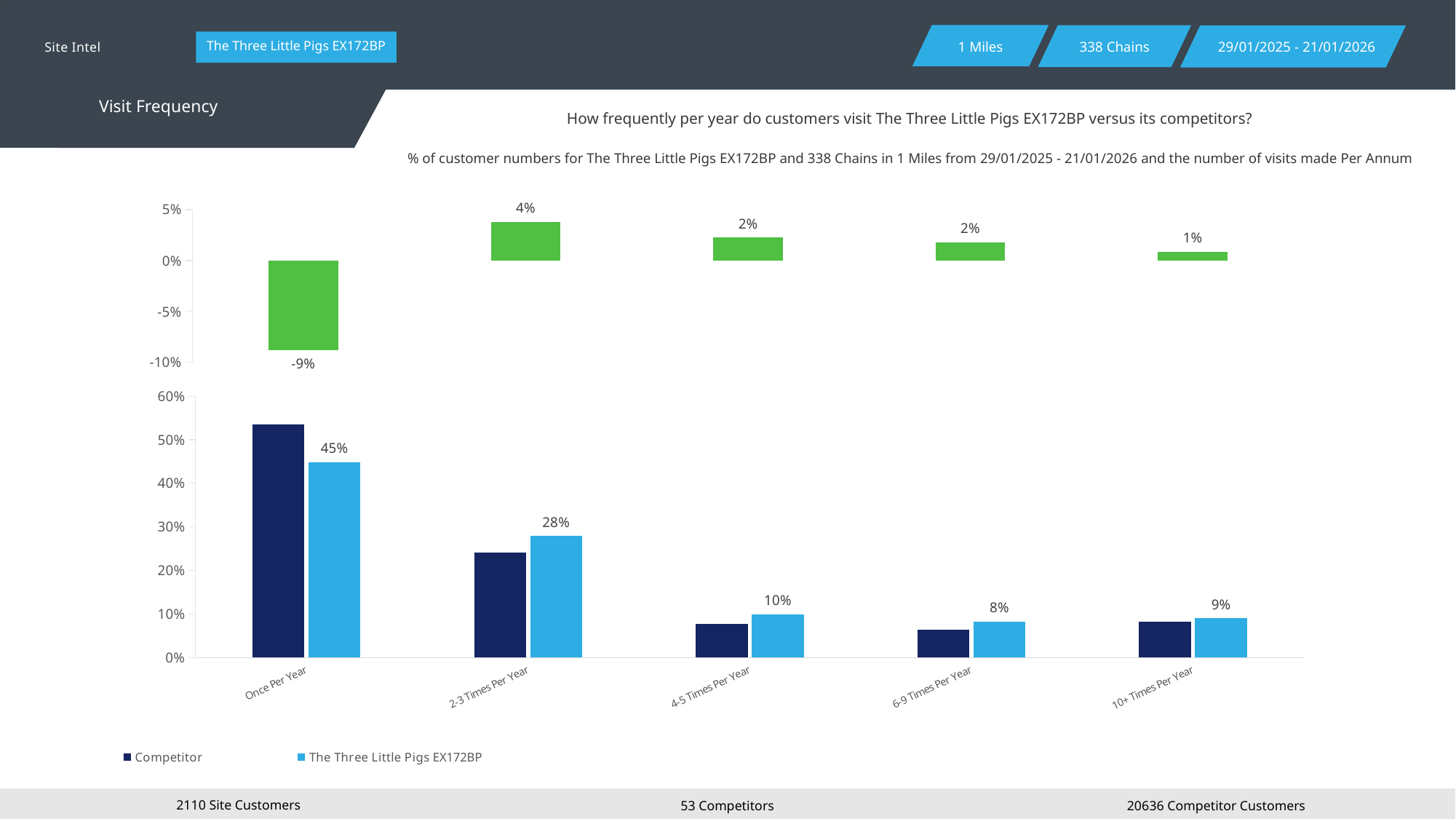
In the bottom chart, what is the value for The Three Little Pigs EX172BP for 2-3 Times Per Year? 28% In the top chart, what is the value shown for Once Per Year? -9% In the bottom chart, what is the difference between The Three Little Pigs EX172BP values for Once Per Year and 2-3 Times Per Year? 17 percentage points In the bottom chart, which category has the highest value for The Three Little Pigs EX172BP? Once Per Year In the bottom chart, is the Competitor value for Once Per Year greater or less than 50%? greater What kind of chart is the bottom chart? bar chart In the bottom chart, what is the value for The Three Little Pigs EX172BP for 6-9 Times Per Year? 8% In the top chart, which category has the highest value? 2-3 Times Per Year In the bottom chart, what is the value for The Three Little Pigs EX172BP for Once Per Year? 45% In the top chart, which category has the lowest value? Once Per Year In the bottom chart, for 2-3 Times Per Year, which is larger: the Competitor value or The Three Little Pigs EX172BP value? The Three Little Pigs EX172BP How many series does the legend of the bottom chart list? 2